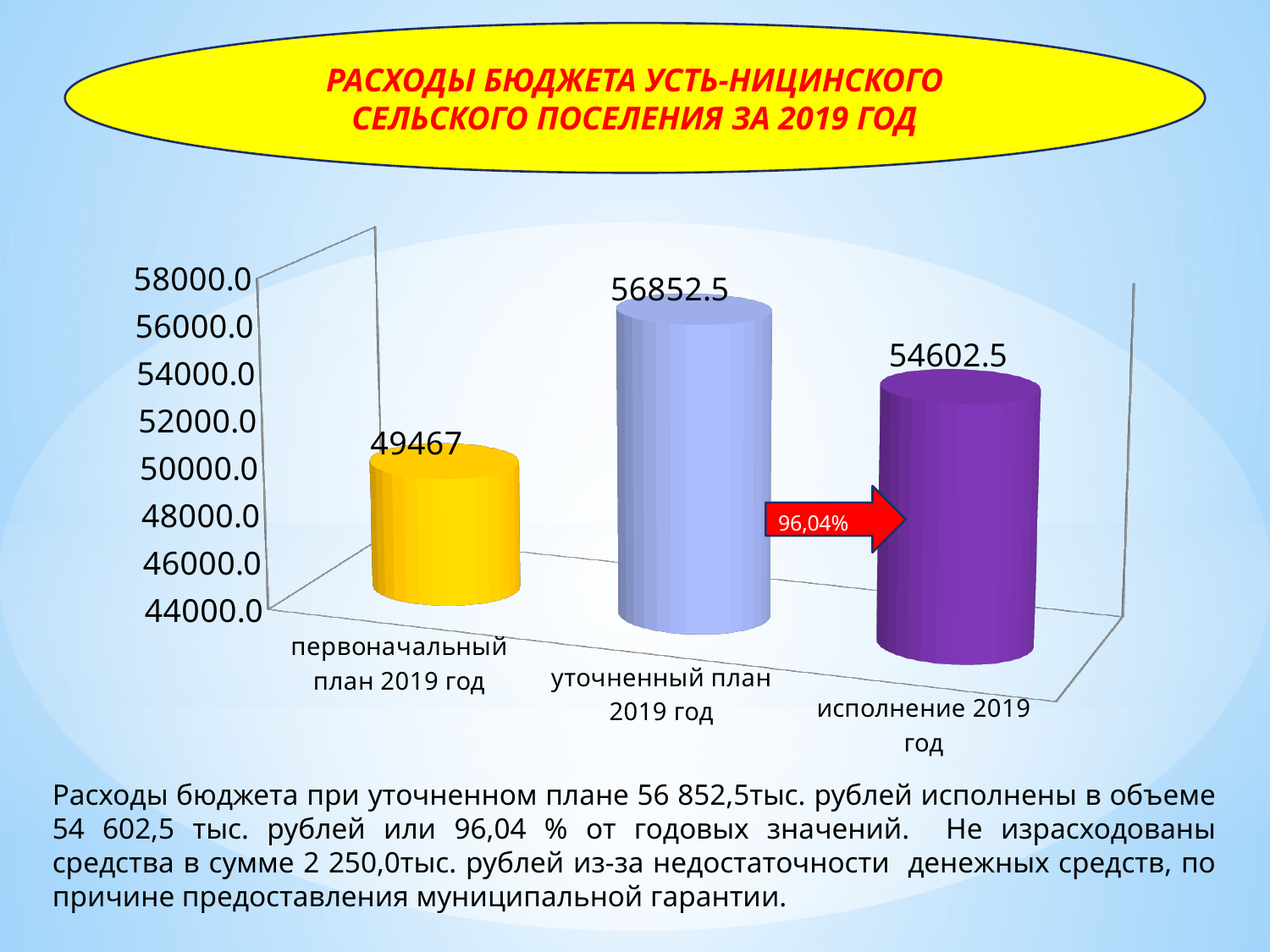
Is the value for «первоначальный план 2019 год» greater or less than 50000.0? less What is the value for «исполнение 2019 год»? 54602.5 How many categories are shown in the chart? 3 Which category has the lowest value? первоначальный план 2019 год What is the difference between «уточненный план 2019 год» and «исполнение 2019 год»? 2250 What is the difference between «уточненный план 2019 год» and «первоначальный план 2019 год»? 7385.5 Which is larger: «исполнение 2019 год» or «первоначальный план 2019 год»? исполнение 2019 год What is the value for «первоначальный план 2019 год»? 49467 Which category has the highest value? уточненный план 2019 год What percentage is shown on the red arrow between the second and third bars? 96,04% What kind of chart is shown on the slide? bar chart What is the value for «уточненный план 2019 год»? 56852.5